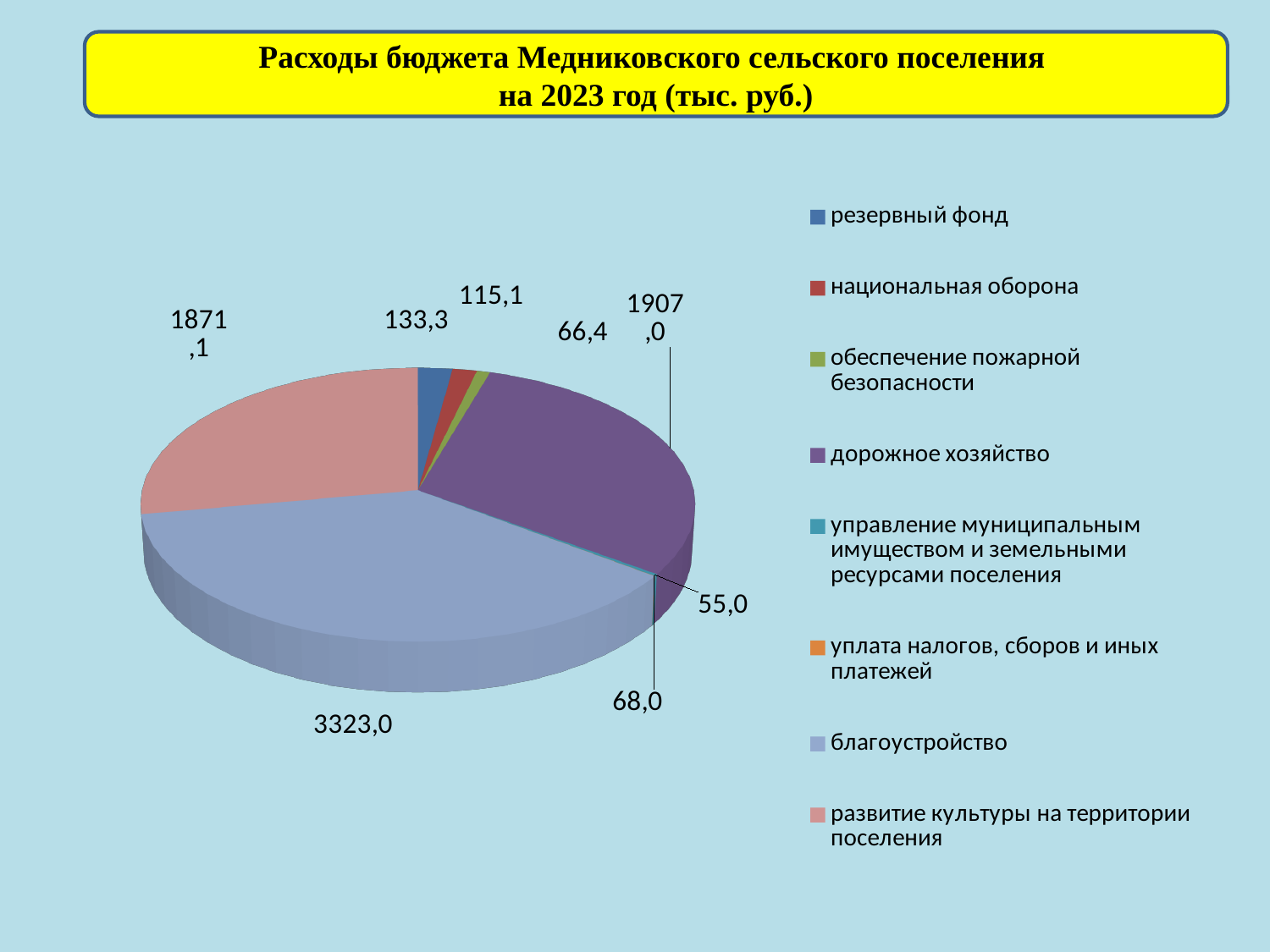
What is the value for национальная оборона? 115,1 Which category has the largest slice of the pie? благоустройство Which category has the smallest value? управление муниципальным имуществом и земельными ресурсами поселения What is the value for обеспечение пожарной безопасности? 66,4 What is the difference between the values for благоустройство and дорожное хозяйство? 1416,0 What is the value for благоустройство? 3323,0 What is the value for резервный фонд? 133,3 How many categories does the legend list? 8 What kind of chart is shown on the slide? pie chart What is the value for дорожное хозяйство? 1907,0 Which is larger, the value for дорожное хозяйство or the value for развитие культуры на территории поселения? дорожное хозяйство What is the value for развитие культуры на территории поселения? 1871,1